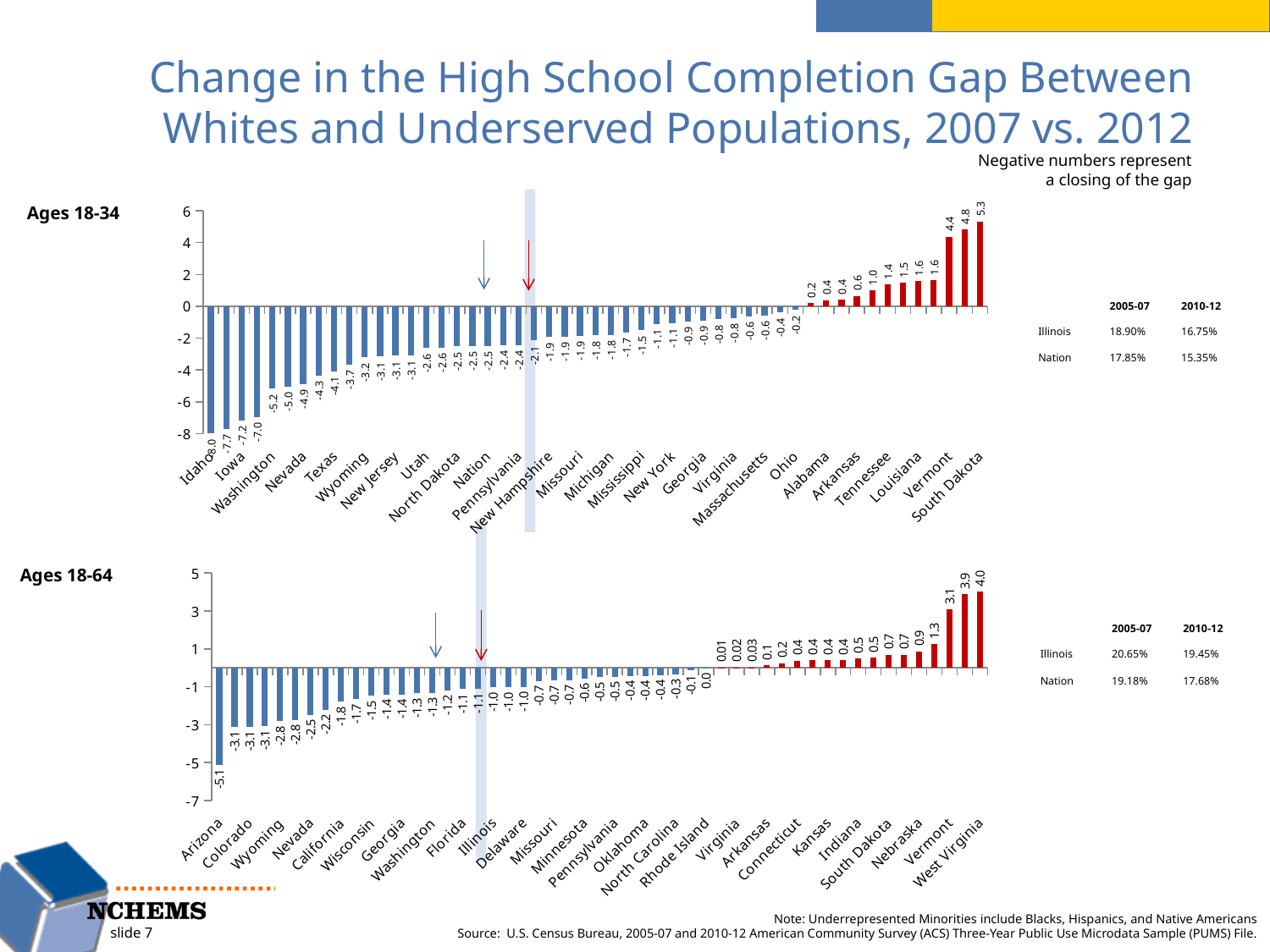
What kind of chart is the Ages 18-64 chart? Bar chart In the Ages 18-34 chart, which state has the lowest value? Idaho In the Ages 18-64 chart, what is the value for Arizona? -5.1 In the Ages 18-64 chart, which is larger, the value for West Virginia or the value for Arizona? West Virginia In the Ages 18-64 chart, which state has the highest value? West Virginia In the Ages 18-64 chart, what is the value for Illinois? -1.0 In the Ages 18-34 chart, what is the value for Idaho? -8.0 In the Ages 18-64 chart, which state has the lowest value? Arizona In the Ages 18-34 chart, do the values rise or fall from left to right along the x axis? Rise In the Ages 18-34 chart, which state has the highest value? South Dakota In the Ages 18-34 chart, what is the value for South Dakota? 5.3 In the Ages 18-34 chart, what is the difference between the values for South Dakota and Idaho? 13.3